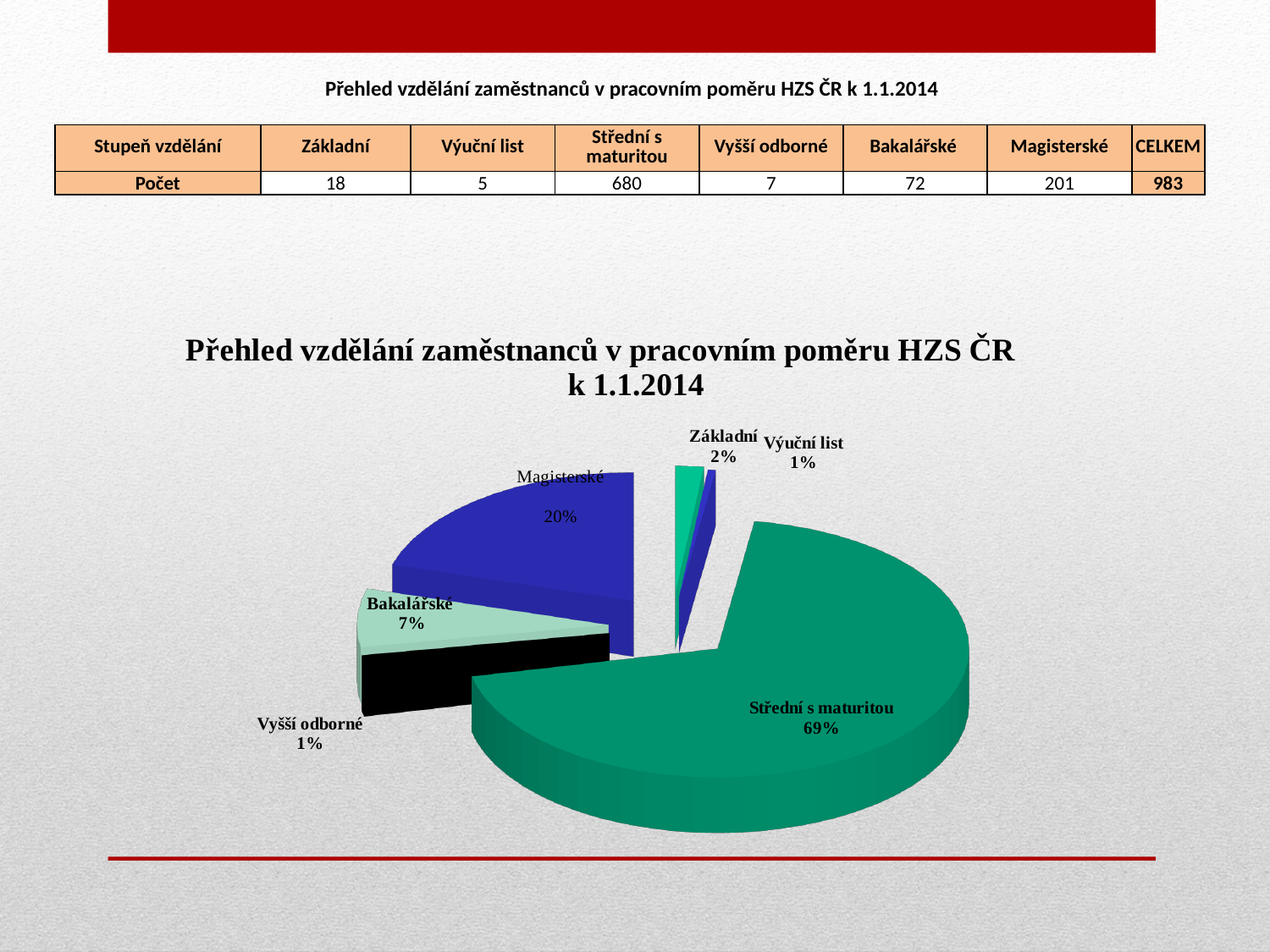
What is the title of the pie chart? Přehled vzdělání zaměstnanců v pracovním poměru HZS ČR k 1.1.2014 What share of the pie does Bakalářské have? 7% Which is larger in the pie chart, Magisterské or Bakalářské? Magisterské What share of the pie does Střední s maturitou have? 69% What share of the pie does Výuční list have? 1% What is the difference in percentage points between the Střední s maturitou slice and the Magisterské slice? 49 Which category has the largest slice of the pie? Střední s maturitou How many slices does the pie chart have? 6 What is the difference in percentage points between the Bakalářské slice and the Základní slice? 5 What kind of chart is shown on the slide? pie chart